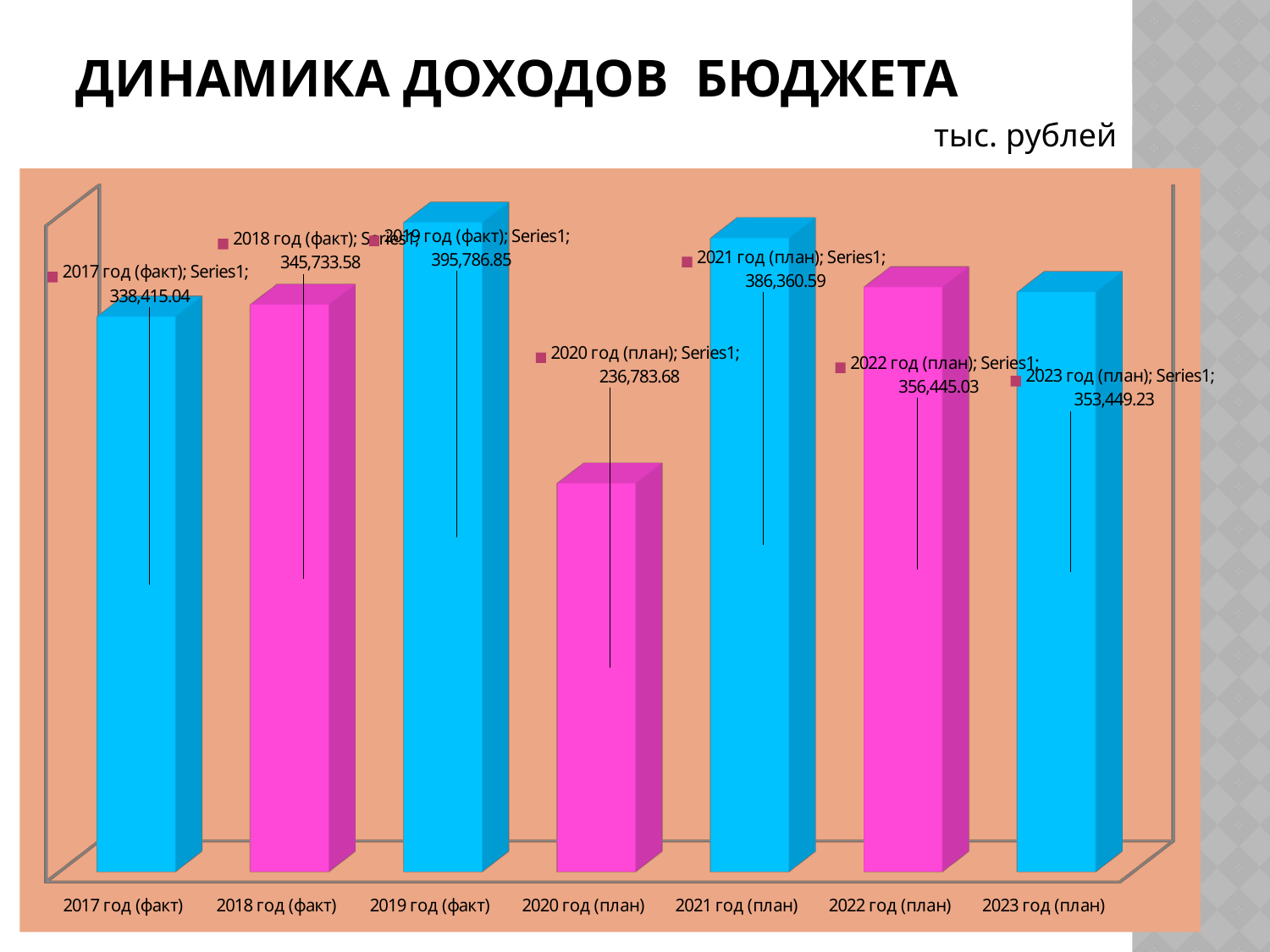
Which is larger, the value for 2021 год (план) or the value for 2022 год (план)? 2021 год (план) What is the value for 2017 год (факт)? 338,415.04 What is the difference between the values for 2021 год (план) and 2017 год (факт)? 47,945.55 What is the value for 2022 год (план)? 356,445.03 What is the value for 2020 год (план)? 236,783.68 Which category has the highest value? 2019 год (факт) What is the difference between the values for 2019 год (факт) and 2020 год (план)? 159,003.17 How many categories are shown on the x axis? 7 What is the value for 2023 год (план)? 353,449.23 Which category has the lowest value? 2020 год (план) What kind of chart is shown on the slide? Bar chart What unit is stated for the values on the slide? тыс. рублей